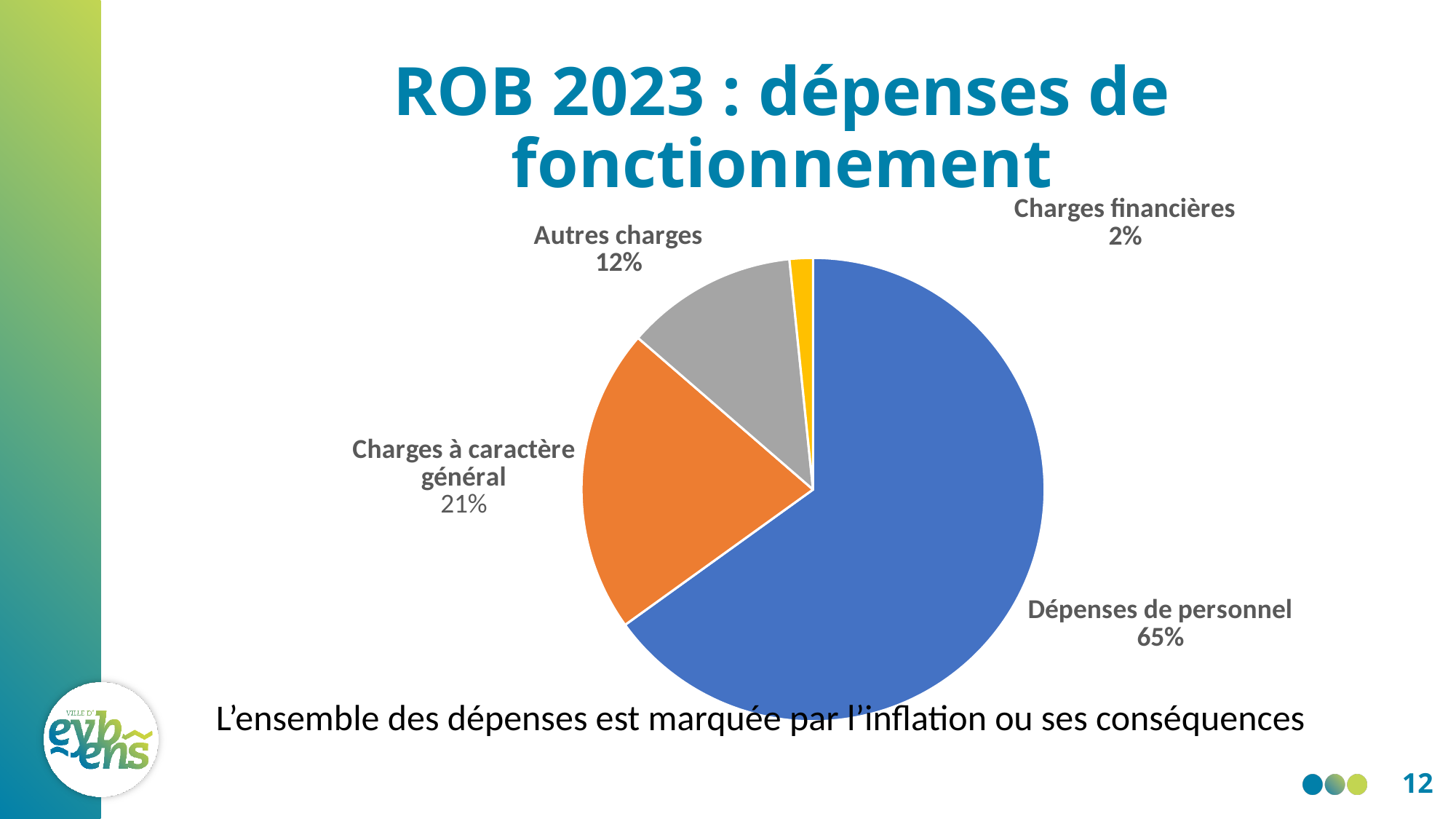
Which is larger, Autres charges or Charges à caractère général? Charges à caractère général What share of the pie is Charges financières? 2% Which category has the smallest slice of the pie? Charges financières What is the difference in percentage points between Dépenses de personnel and Charges à caractère général? 44 What is the difference in percentage points between Autres charges and Charges financières? 10 What share of the pie is Charges à caractère général? 21% What share of the pie is Autres charges? 12% Which category has the largest slice of the pie? Dépenses de personnel What colour is the slice for Dépenses de personnel? blue What kind of chart is shown on the slide? pie chart How many slices does the pie chart have? 4